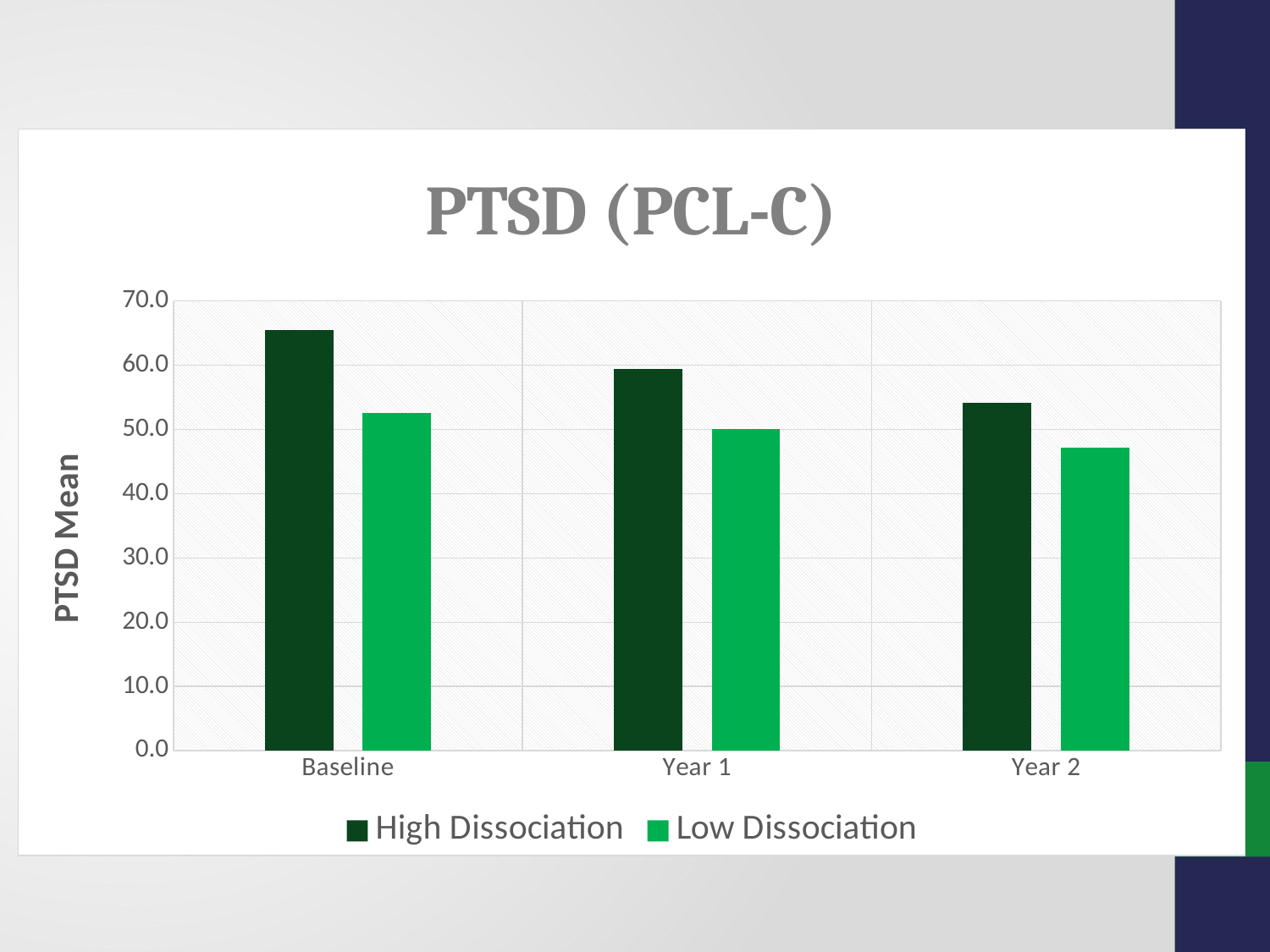
How many categories are shown on the x axis? 3 Is the High Dissociation value at Year 2 greater or less than 50? greater What is the label of the y axis? PTSD Mean Is the High Dissociation value at Baseline greater or less than 60? greater At which time point is the Low Dissociation value lowest? Year 2 How many series does the legend list? 2 What is the title of the chart? PTSD (PCL-C) At which time point is the High Dissociation value highest? Baseline Is the Low Dissociation value at Year 2 greater or less than 50? less What type of chart is shown on the slide? bar chart At Baseline, which group has the larger PTSD mean, High Dissociation or Low Dissociation? High Dissociation